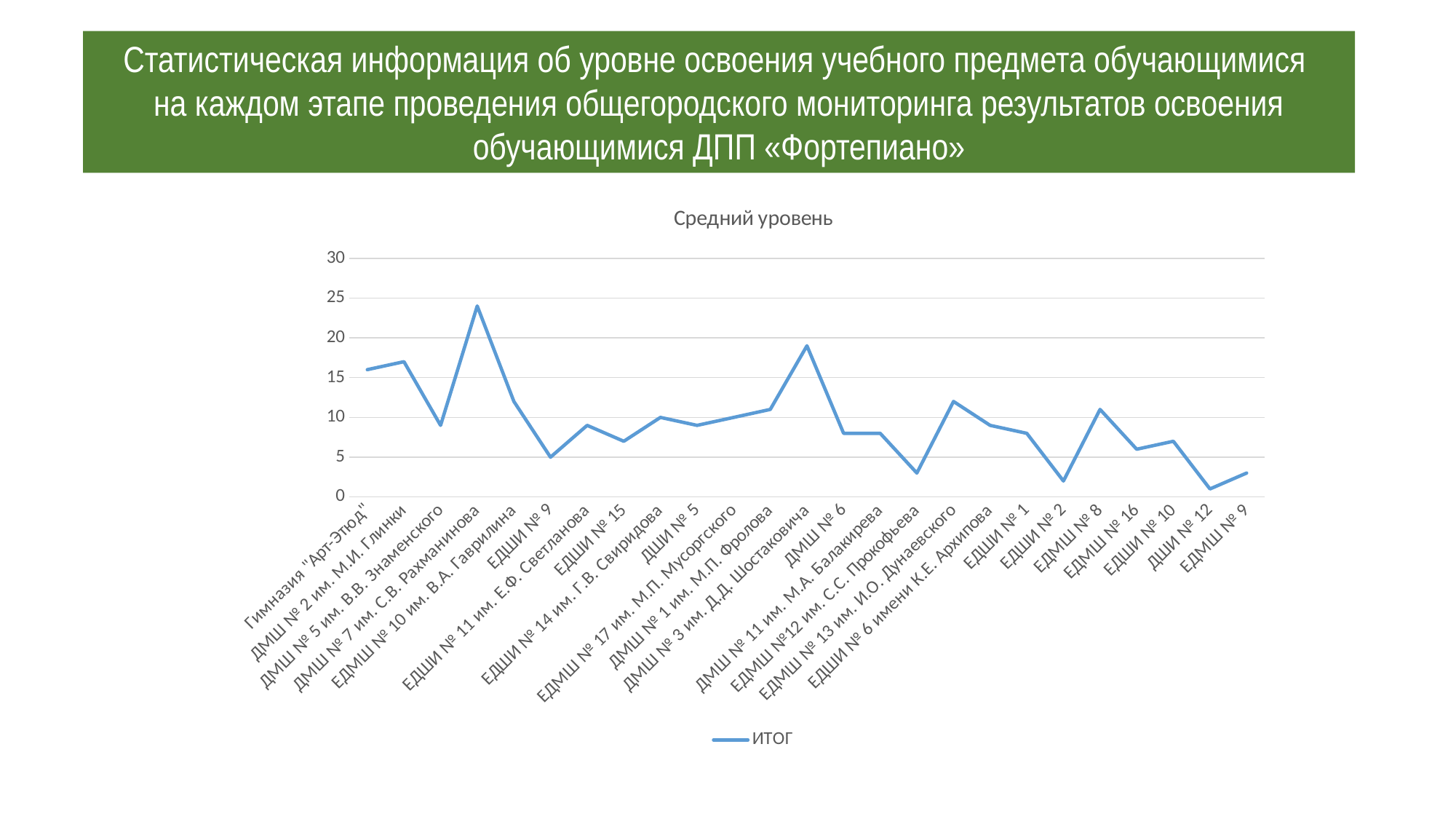
What kind of chart is shown on the slide? line chart Is the value for ЕДШИ № 2 greater or less than 5? less How many series does the legend list? 1 Is the value for ДМШ № 7 им. С.В. Рахманинова greater or less than 20? greater Which has the larger value: ДМШ № 7 им. С.В. Рахманинова or ДМШ № 3 им. Д.Д. Шостаковича? ДМШ № 7 им. С.В. Рахманинова Which school has the highest value on the chart? ДМШ № 7 им. С.В. Рахманинова What is the name of the series shown in the legend? ИТОГ What is the title of the chart? Средний уровень How many schools (categories) are plotted along the x axis? 25 Does the line rise or fall between ДМШ № 7 им. С.В. Рахманинова and ЕДШИ № 9? fall Which school has the lowest value on the chart? ДШИ № 12 Is the value for ДМШ № 3 им. Д.Д. Шостаковича greater or less than 15? greater